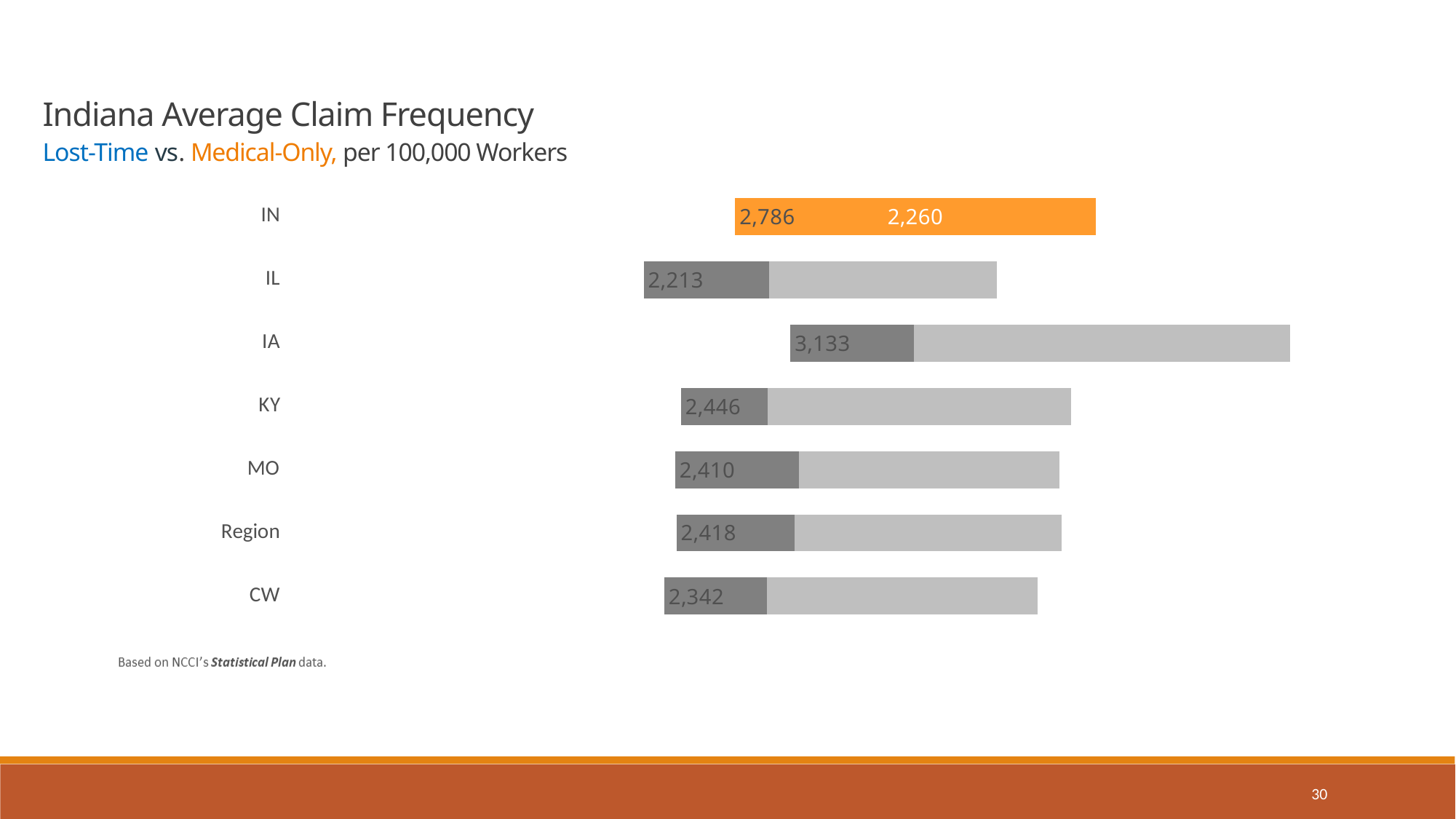
Which category's bar is highlighted in orange? IN Which has the larger printed value, KY or MO? KY What is the second value printed on the IN bar? 2,260 What value is printed on the IA bar? 3,133 How many categories are shown on the chart? 7 What is the first value printed on the IN bar? 2,786 Which category has the lowest printed value? IL What is the difference between the printed values for IA and IL? 920 What value is printed on the Region bar? 2,418 Which category has the highest printed value? IA What value is printed on the CW bar? 2,342 What type of chart is shown on the slide? bar chart